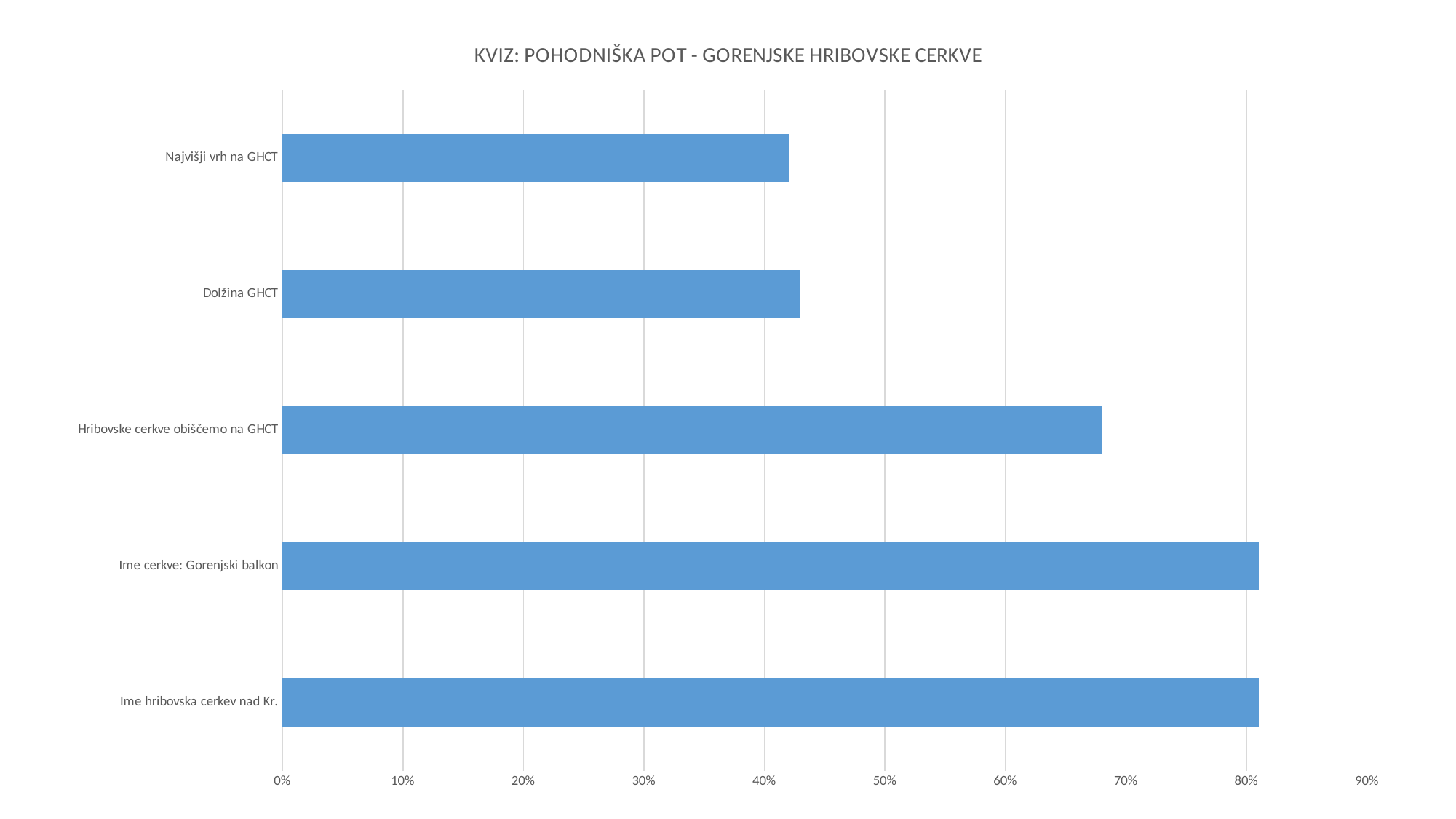
Is the value for Najvišji vrh na GHCT greater or less than 50%? less Is the value for Ime cerkve: Gorenjski balkon greater or less than 70%? greater Which has the larger value: Hribovske cerkve obiščemo na GHCT or Dolžina GHCT? Hribovske cerkve obiščemo na GHCT Is the value for Hribovske cerkve obiščemo na GHCT greater or less than 60%? greater What is the highest value shown on the horizontal axis? 90% What kind of chart is shown on the slide? bar chart How many categories (bars) does the chart show? 5 Which has the larger value: Najvišji vrh na GHCT or Ime cerkve: Gorenjski balkon? Ime cerkve: Gorenjski balkon What is the title of the chart? KVIZ: POHODNIŠKA POT - GORENJSKE HRIBOVSKE CERKVE